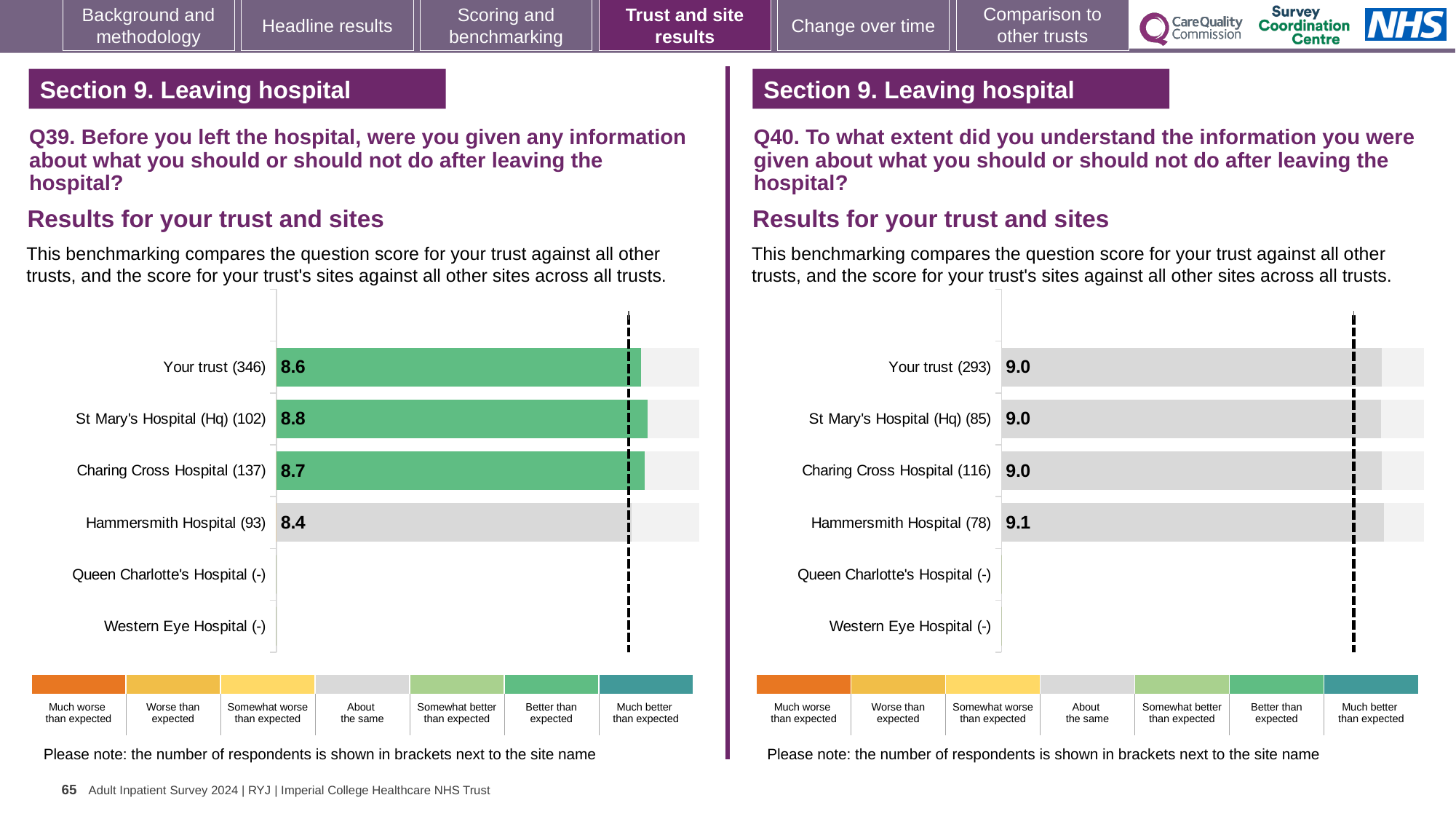
In the Q39 chart on the left, which has the higher score: Charing Cross Hospital or Your trust? Charing Cross Hospital What kind of chart is used for the Q40 results on the right? Bar chart In the Q39 chart on the left, what is the difference between the scores for St Mary's Hospital (Hq) and Hammersmith Hospital? 0.4 How many sites (including Your trust) are listed on the y axis of the Q39 chart on the left? 6 In the Q40 chart on the right, what is the score for Hammersmith Hospital? 9.1 In the Q40 chart on the right, what is the score for Charing Cross Hospital? 9.0 In the Q39 chart on the left, how many respondents are shown in brackets for Your trust? 346 In the Q39 chart on the left, what is the score for Hammersmith Hospital? 8.4 In the Q40 chart on the right, which site has the highest score? Hammersmith Hospital In the Q39 chart on the left, which site has the lowest score? Hammersmith Hospital In the Q39 chart on the left, what is the score for Your trust? 8.6 In the Q39 chart on the left, which site has the highest score? St Mary's Hospital (Hq)